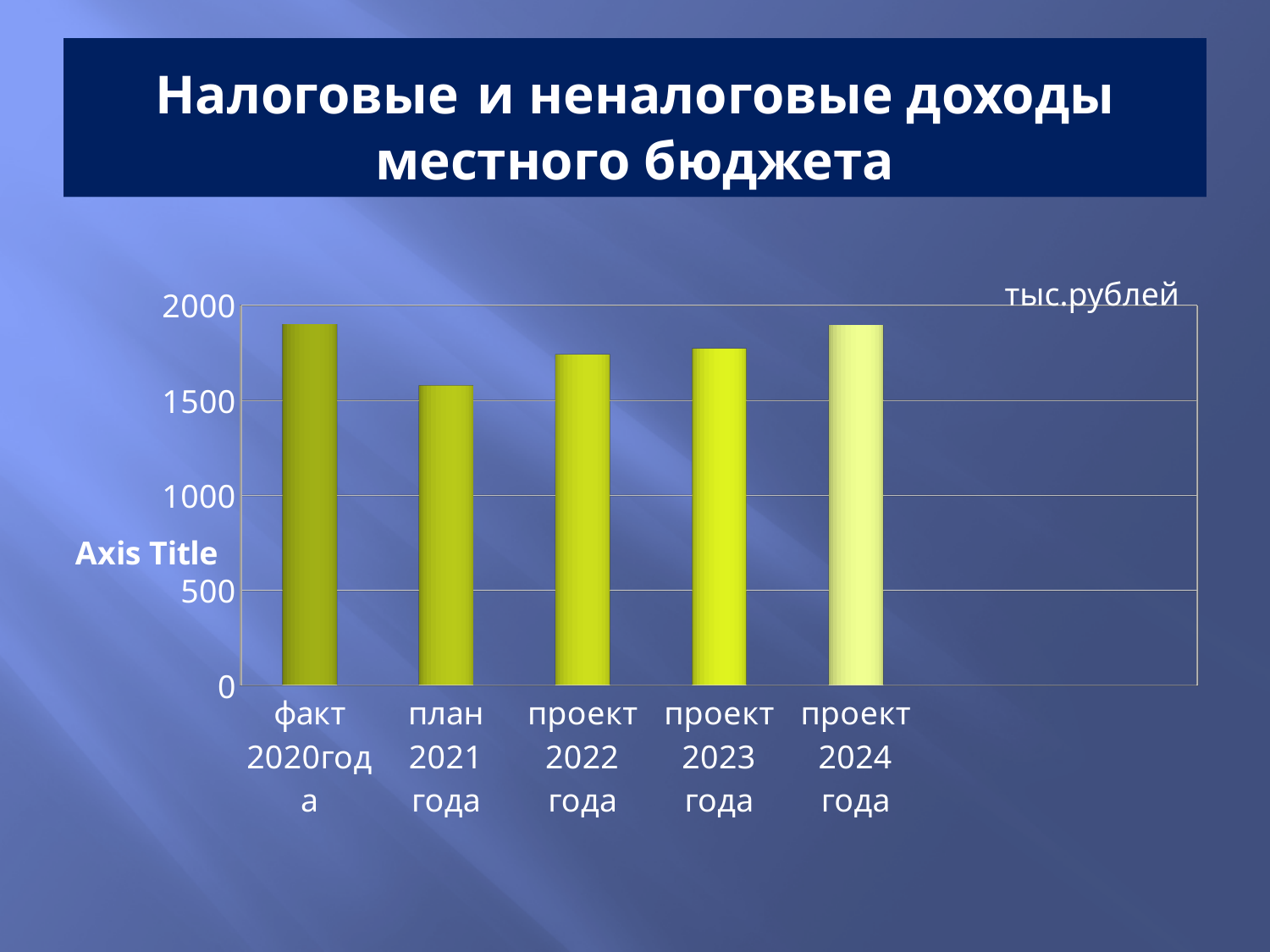
What kind of chart is shown on the slide? bar chart Is the value for проект 2023 года greater or less than 2000? less Which category has the lowest value on the chart? план 2021 года Is the value for факт 2020 года greater or less than 2000? less Is the value for план 2021 года greater or less than 1500? greater How many categories (bars) are plotted on the chart? 5 Which is larger, the value for факт 2020 года or the value for план 2021 года? факт 2020 года Which is larger, the value for план 2021 года or the value for проект 2022 года? проект 2022 года What is the title of the chart on the slide? Налоговые и неналоговые доходы местного бюджета What unit label is shown at the top right of the chart? тыс.рублей